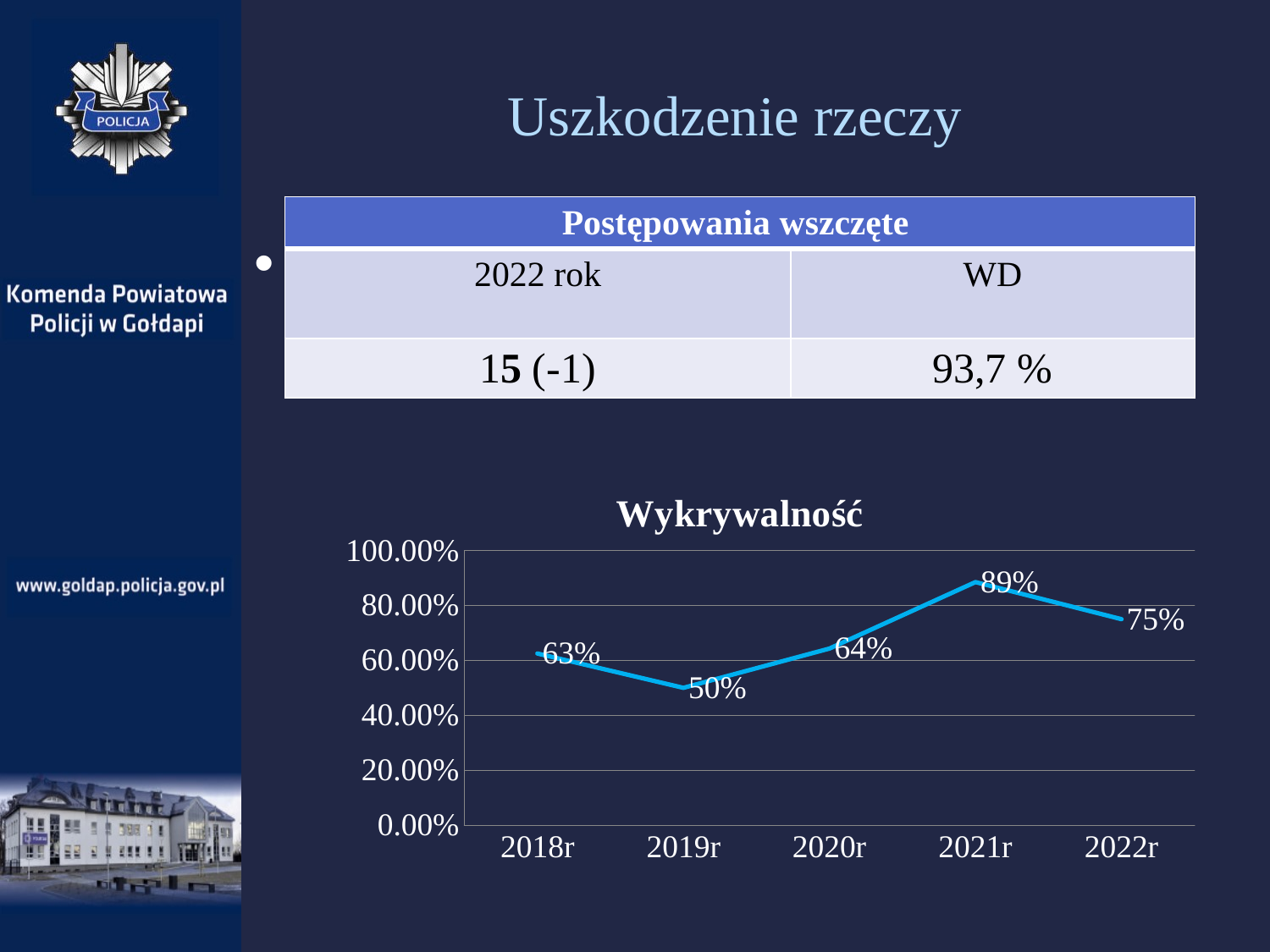
What is the value for 2019r in the Wykrywalność chart? 50% What is the difference between the values for 2021r and 2022r in the Wykrywalność chart? 14% What is the value for 2018r in the Wykrywalność chart? 63% Which is larger in the Wykrywalność chart, the value for 2020r or the value for 2018r? 2020r What is the value for 2021r in the Wykrywalność chart? 89% Which year has the lowest value in the Wykrywalność chart? 2019r What is the title of the chart on the slide? Wykrywalność Which year has the highest value in the Wykrywalność chart? 2021r What kind of chart is shown under the title Wykrywalność? line chart Does the value in the Wykrywalność chart rise or fall from 2019r to 2021r? rise How many years are plotted in the Wykrywalność chart? 5 What is the value for 2022r in the Wykrywalność chart? 75%